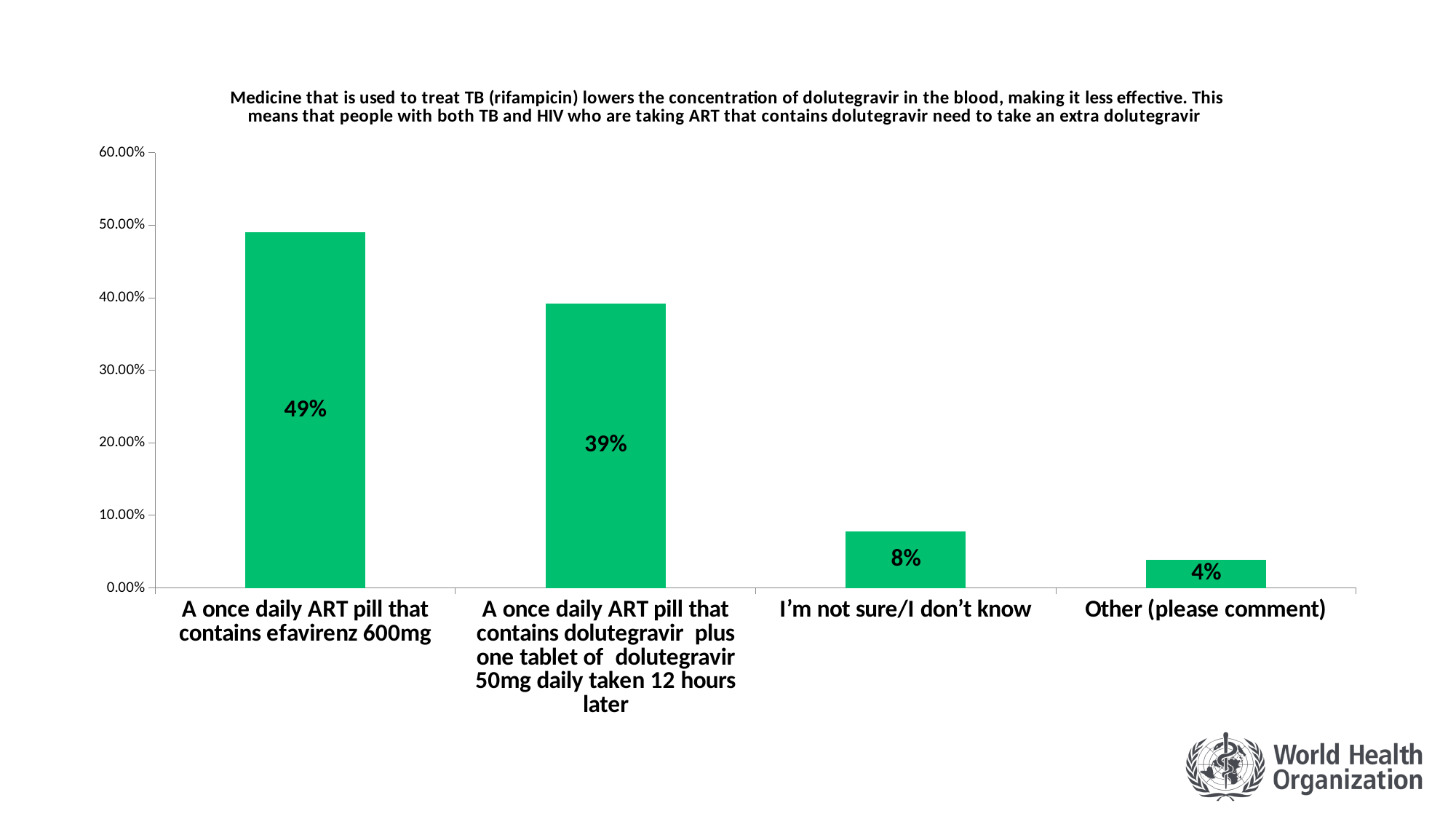
What kind of chart is shown on the slide? Bar chart What is the difference between the values for the efavirenz 600mg option and the dolutegravir plus extra tablet option? 10% What is the value for "Other (please comment)"? 4% Which category has the lowest value? Other (please comment) What is the value for "A once daily ART pill that contains efavirenz 600mg"? 49% What colour are the bars in the chart? Green Is the value for "A once daily ART pill that contains efavirenz 600mg" greater or less than 40.00%? greater Which category has the highest value? A once daily ART pill that contains efavirenz 600mg What is the value for "A once daily ART pill that contains dolutegravir plus one tablet of dolutegravir 50mg daily taken 12 hours later"? 39% What is the value for "I'm not sure/I don't know"? 8% Which is larger: the value for "I'm not sure/I don't know" or the value for "Other (please comment)"? I'm not sure/I don't know How many categories are shown on the chart? 4